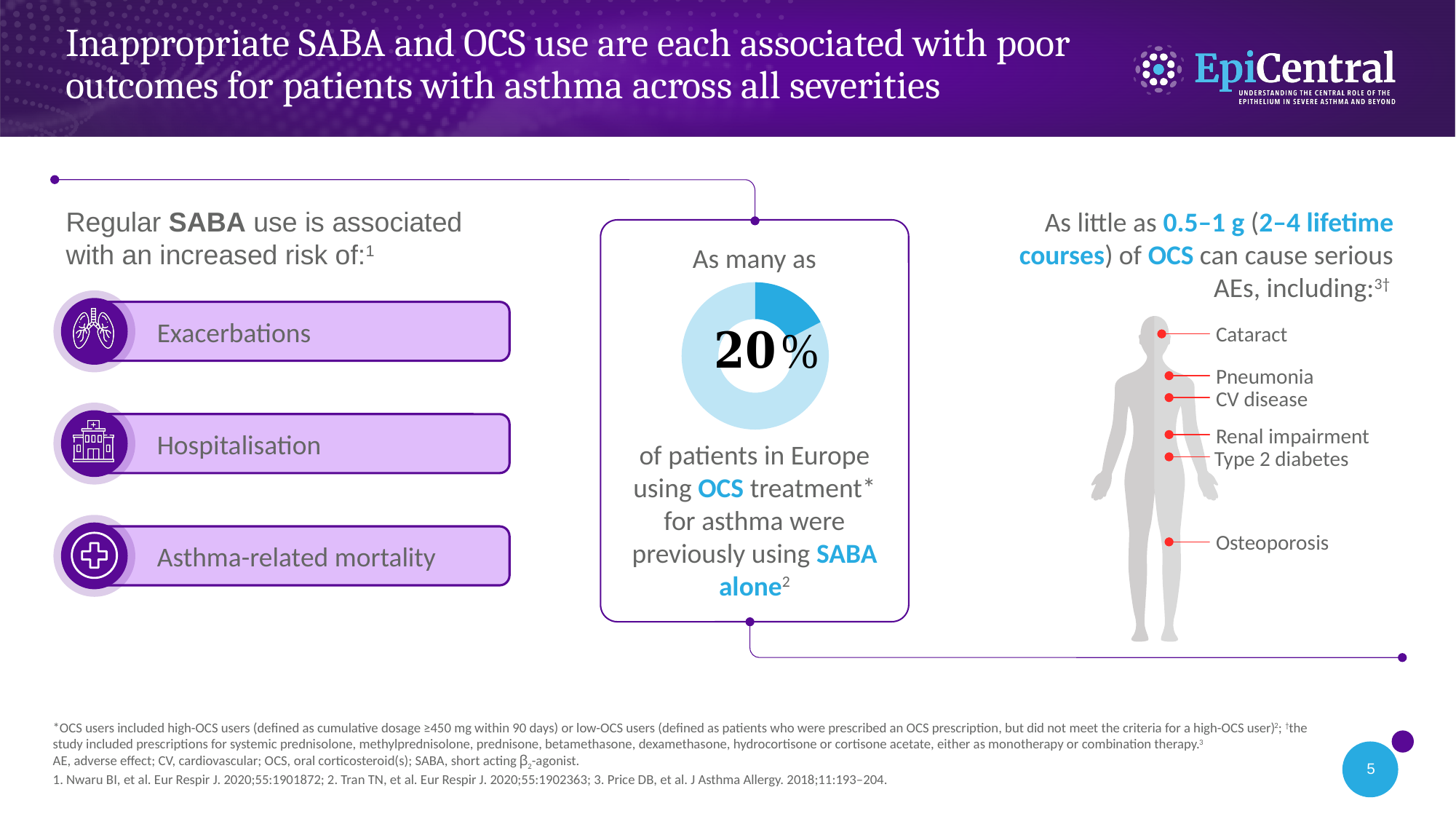
In the donut chart, is the dark blue segment larger or smaller than the light blue segment? Smaller What colour is the segment of the donut chart that represents the 20% value? Dark blue What share of the donut chart is represented by the light blue (remaining) segment? 80% What percentage is printed in the centre of the donut chart? 20% What kind of chart is shown in the centre of the slide? Donut (pie) chart Is the value highlighted in the donut chart greater or less than 50%? less According to the donut chart, what share of patients in Europe using OCS treatment for asthma were previously using SABA alone? 20% What phrase appears directly above the donut chart? As many as How many segments does the donut chart have? 2